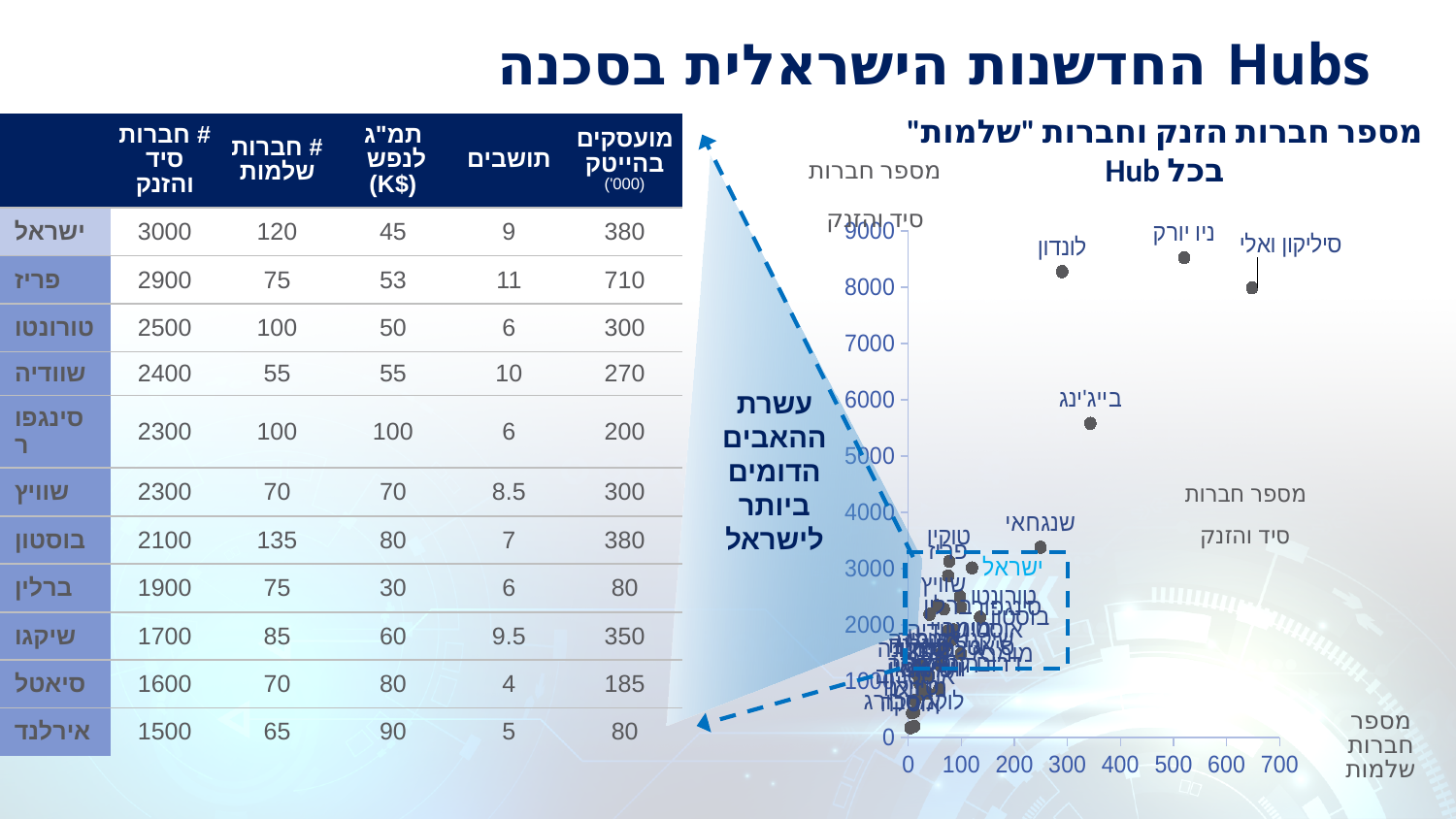
In the scatter chart, is the number of seed and startup companies (y axis) for שנגחאי greater or less than 3000? greater What is the title of the chart on the right side of the slide? מספר חברות הזנק וחברות "שלמות" בכל Hub In the scatter chart, is the number of complete companies (x axis) for סיליקון ואלי greater or less than 600? greater What kind of chart is shown on the right side of the slide? scatter chart In the scatter chart, is the number of seed and startup companies (y axis) for בייג'ינג greater or less than 6000? less In the scatter chart, which hub has the highest number of complete companies (furthest right on the x axis)? סיליקון ואלי In the scatter chart, which hub has more seed and startup companies (y axis): ניו יורק or סיליקון ואלי? ניו יורק In the scatter chart, what does the horizontal axis represent? מספר חברות שלמות